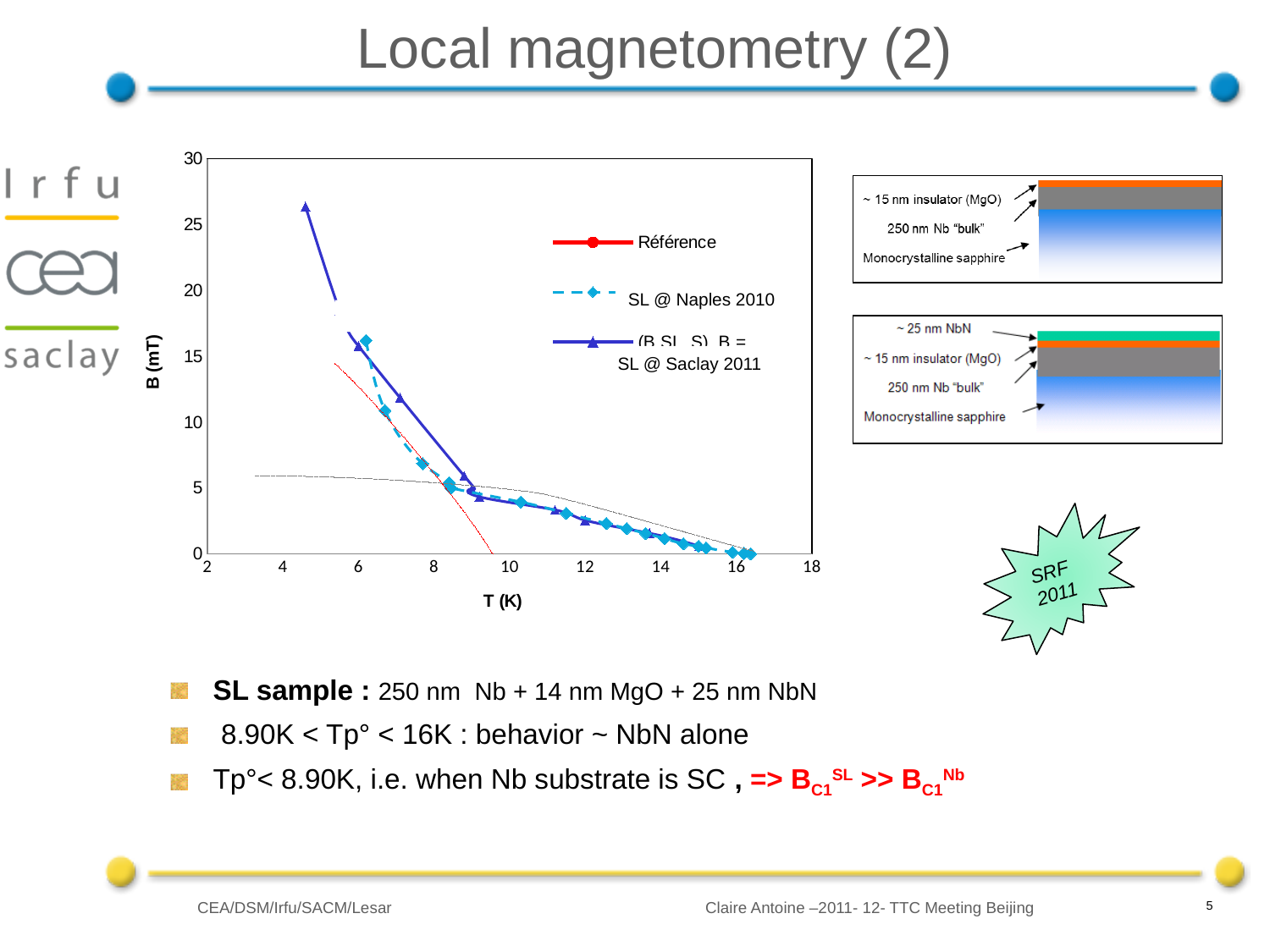
Which series reaches the highest B value on the chart? SL @ Saclay 2011 Is the value of the SL @ Naples 2010 series at about 12 K greater or less than 5 mT? less What kind of chart is shown on the slide? line chart How many series does the chart legend list? 3 Is the value of the SL @ Saclay 2011 series at its lowest temperature point (around 4.6 K) greater or less than 20 mT? greater Is the value of the SL @ Saclay 2011 series at about 6 K greater or less than 10 mT? greater What is the label of the y axis of the chart? B (mT) What is the label of the x axis of the chart? T (K) What is the maximum value shown on the y axis of the chart? 30 Do the values of the SL @ Saclay 2011 series rise or fall as T (K) increases? fall